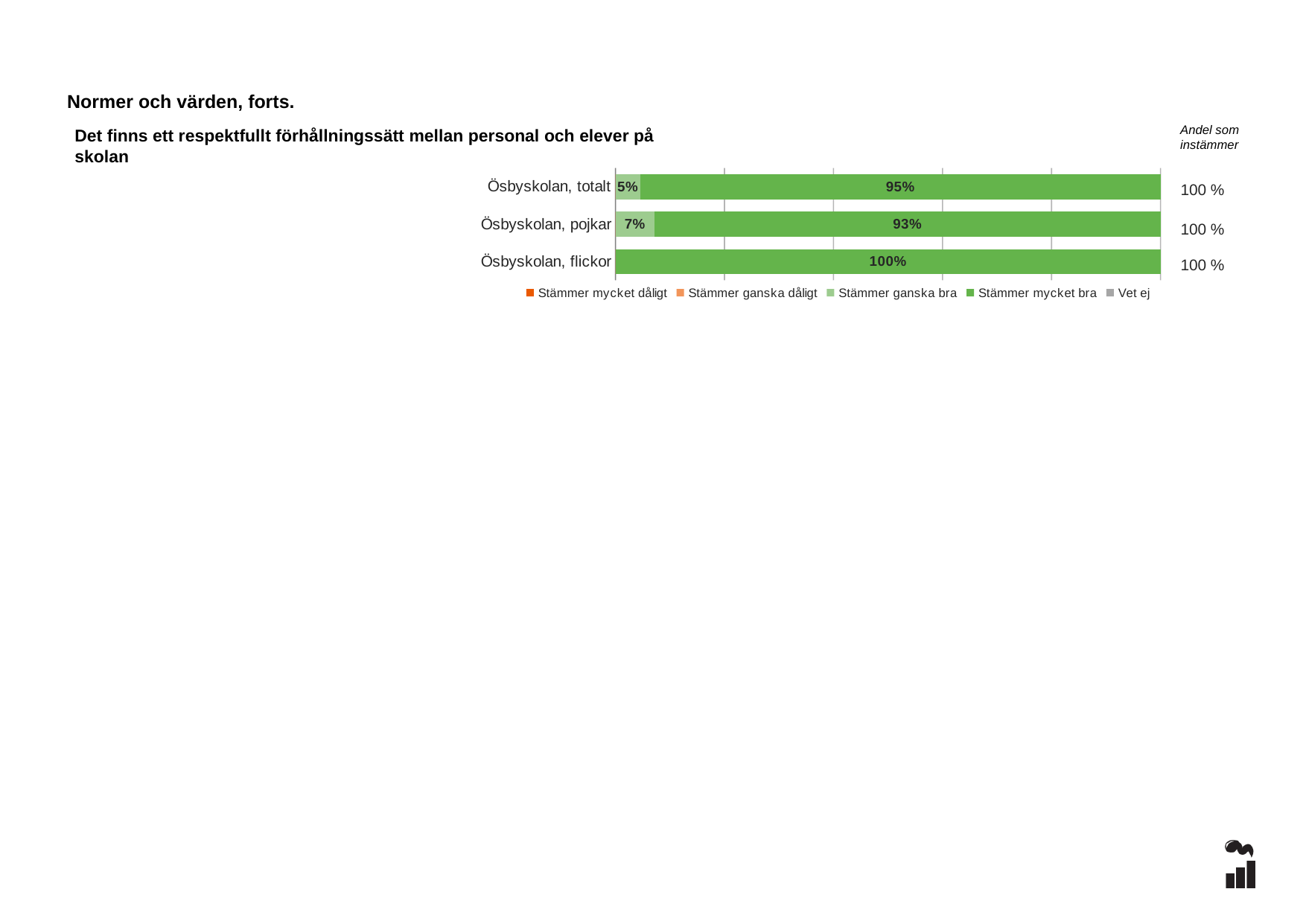
What kind of chart is shown on the slide? Stacked bar chart Which category has the lowest value for "Stämmer mycket bra"? Ösbyskolan, pojkar What is the value of "Stämmer ganska bra" for Ösbyskolan, totalt? 5% What is the value of "Stämmer ganska bra" for Ösbyskolan, pojkar? 7% Which is larger: the "Stämmer ganska bra" value for Ösbyskolan, pojkar or for Ösbyskolan, totalt? Ösbyskolan, pojkar What is the value of "Stämmer mycket bra" for Ösbyskolan, totalt? 95% How many categories are shown on the y axis of the chart? 3 What is the "Andel som instämmer" value shown for Ösbyskolan, pojkar? 100 % Which category has the highest value for "Stämmer mycket bra"? Ösbyskolan, flickor What is the value of "Stämmer mycket bra" for Ösbyskolan, flickor? 100% What is the difference between the "Stämmer mycket bra" values for Ösbyskolan, flickor and Ösbyskolan, pojkar? 7% How many series does the legend list? 5